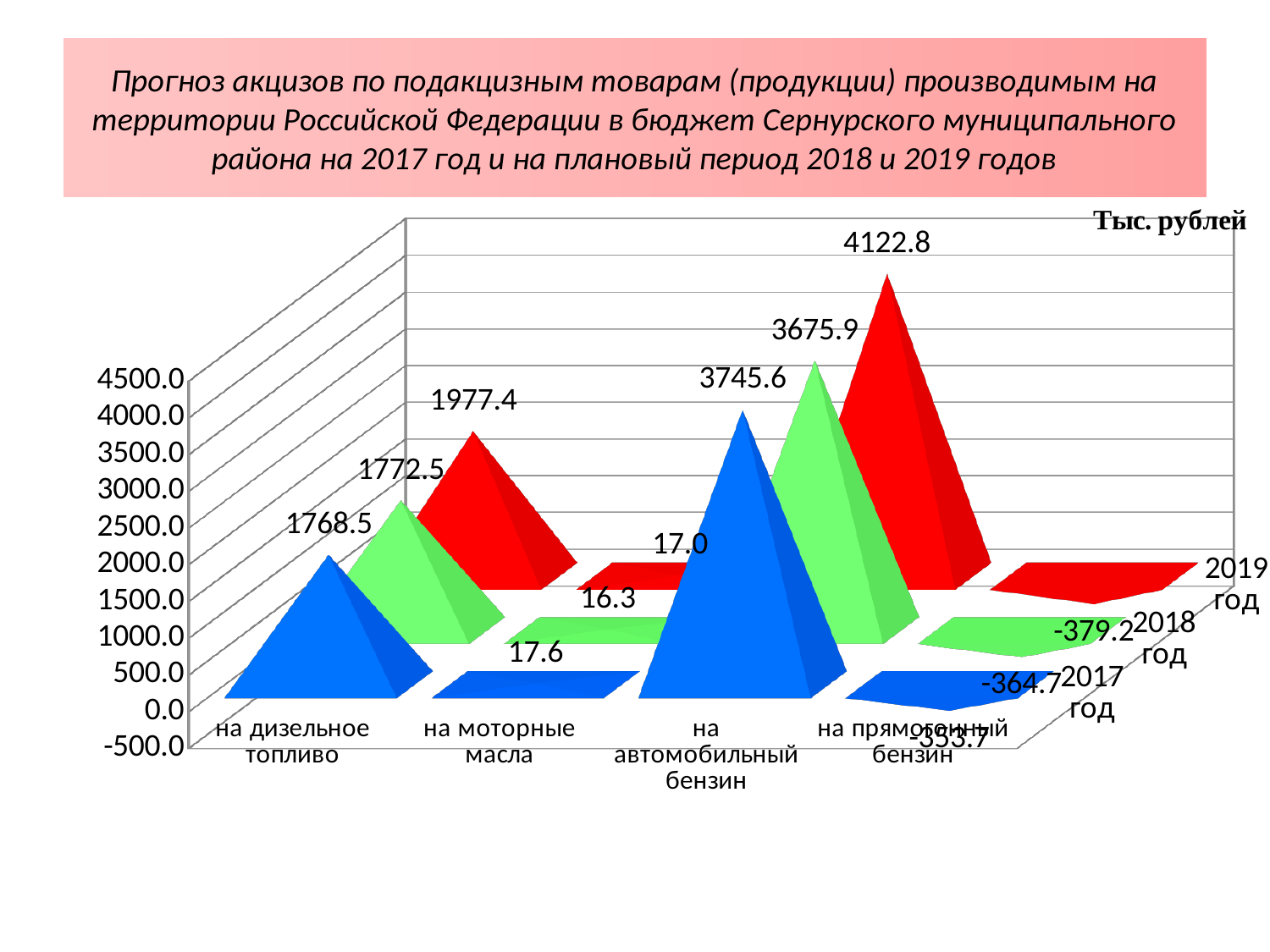
What type of chart is shown on the slide? bar chart Which is larger for 'на дизельное топливо': the 2018 год value or the 2019 год value? 2019 год What is the difference between the 2019 год and 2017 год values for 'на автомобильный бензин'? 377.2 What unit is indicated in the top right corner of the chart? Тыс. рублей What is the forecast value for 'на моторные масла' in 2018 год? 16.3 What is the forecast value for 'на дизельное топливо' in 2019 год? 1977.4 What is the forecast value for 'на дизельное топливо' in 2017 год? 1768.5 Which category has the highest value in 2019 год? на автомобильный бензин Which category has the lowest value in 2018 год? на прямогонный бензин How many product categories are shown on the x axis of the chart? 4 How many series (years) does the chart show? 3 What is the forecast value for 'на автомобильный бензин' in 2019 год? 4122.8